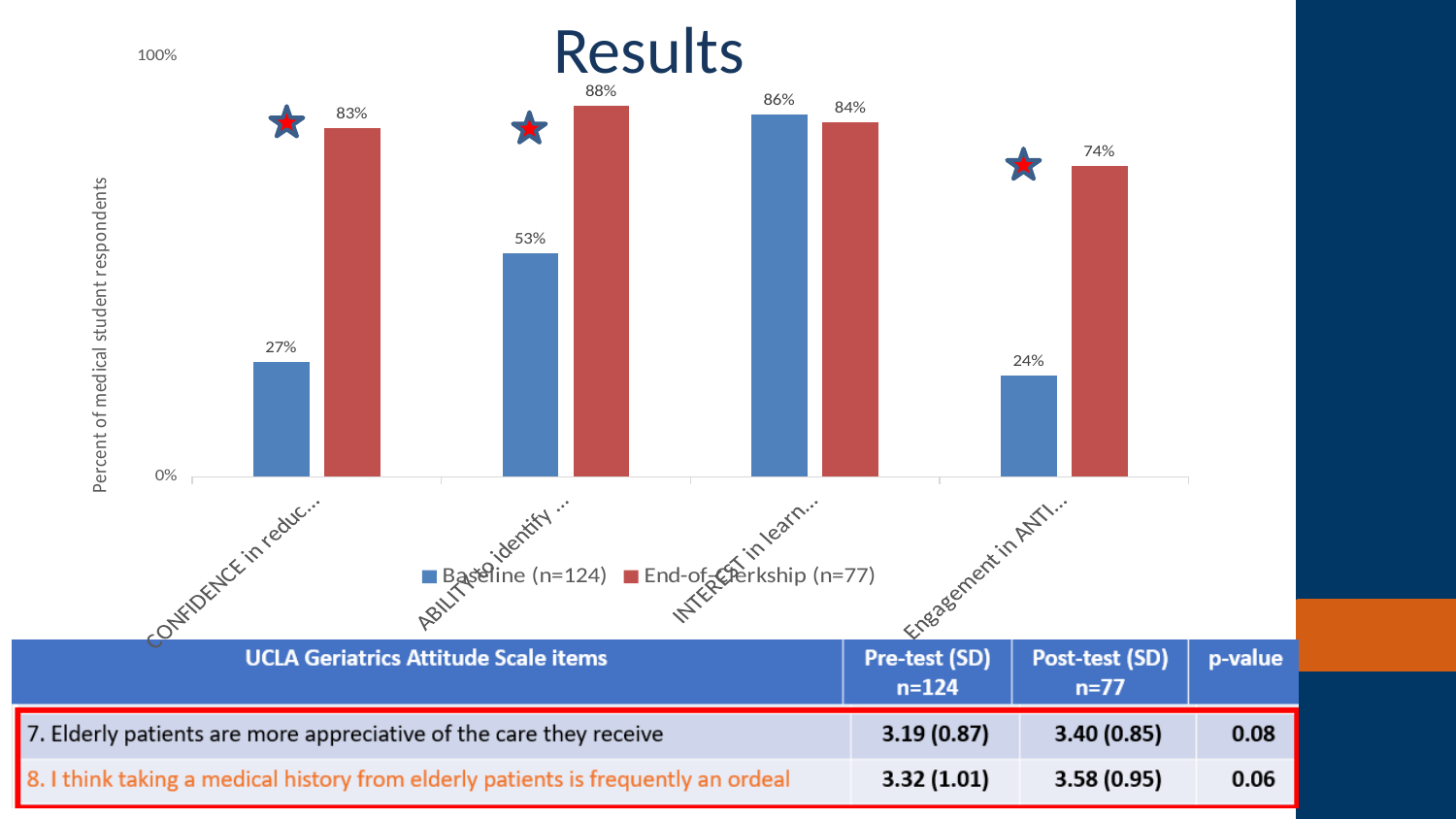
What is the Baseline (n=124) value for the first category (CONFIDENCE in reduc...)? 27% What is the End-of-Clerkship (n=77) value for the fourth category (Engagement in ANTI...)? 74% What is the label on the chart's vertical axis? Percent of medical student respondents What is the difference between the End-of-Clerkship and Baseline values for the first category (CONFIDENCE in reduc...)? 56 percentage points How many categories are plotted along the x axis of the chart? 4 For the third category (INTEREST in learn...), which is larger: the Baseline (n=124) value or the End-of-Clerkship (n=77) value? Baseline (n=124) What is the End-of-Clerkship (n=77) value for the first category (CONFIDENCE in reduc...)? 83% Which category has the lowest Baseline (n=124) value? Engagement in ANTI... (24%) How many series does the chart's legend list? 2 What type of chart is shown on the slide? Bar chart What is the Baseline (n=124) value for the second category (ABILITY to identify ...)? 53% Which category has the highest End-of-Clerkship (n=77) value? ABILITY to identify ... (88%)